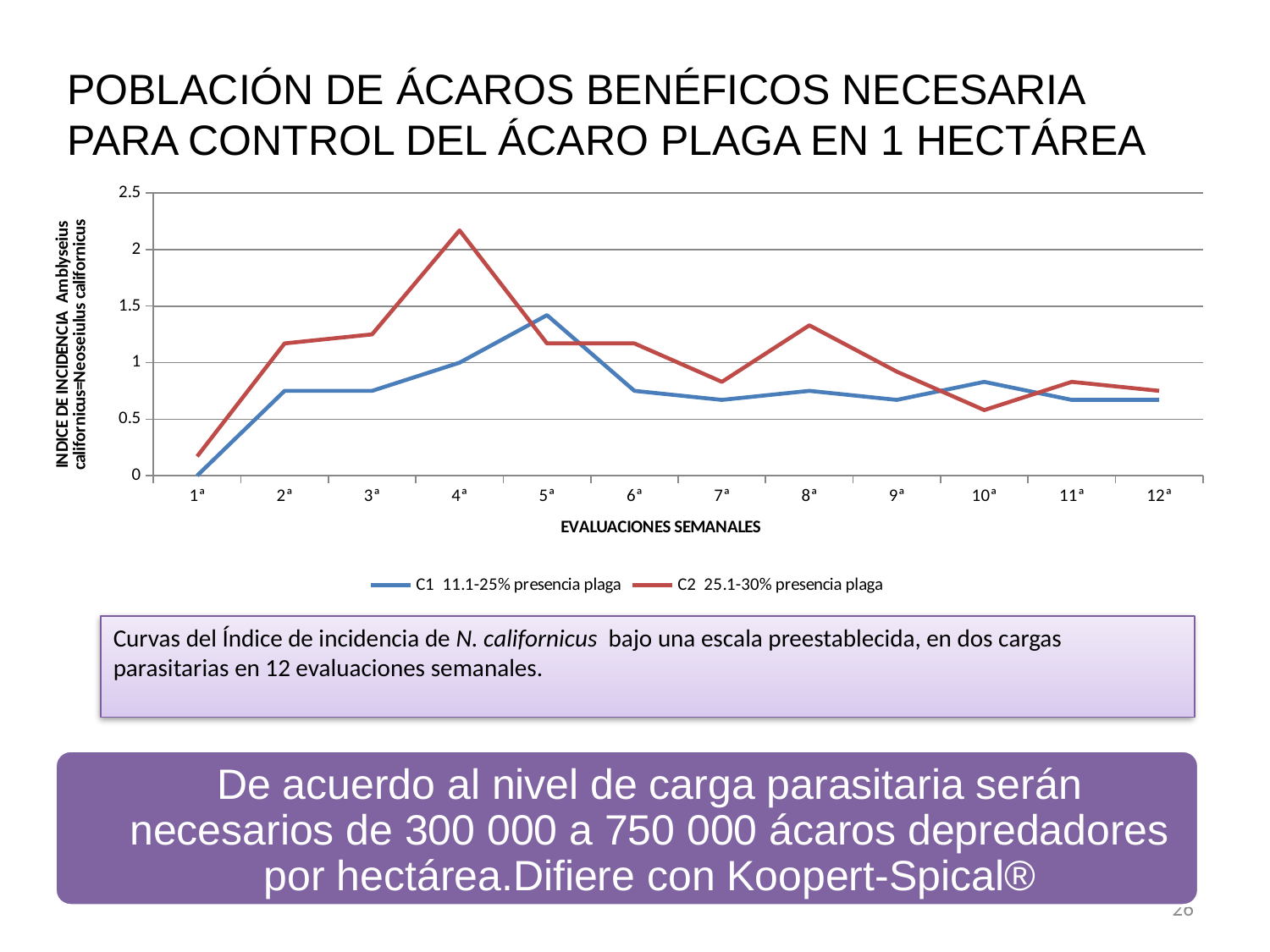
What is the value of the series C1 11.1-25% presencia plaga at evaluation 1ª? 0 At evaluation 4ª, which series has the larger value, C1 11.1-25% presencia plaga or C2 25.1-30% presencia plaga? C2 25.1-30% presencia plaga How many weekly evaluations are plotted along the x axis? 12 What kind of chart is shown on the slide? line chart How many series does the legend list? 2 Is the value for C2 25.1-30% presencia plaga at evaluation 4ª greater or less than 2? greater What is the title of the x axis of the chart? EVALUACIONES SEMANALES At which evaluation is the series C1 11.1-25% presencia plaga at its lowest value? 1ª At which evaluation does the series C1 11.1-25% presencia plaga reach its highest value? 5ª Is the value for C2 25.1-30% presencia plaga at evaluation 10ª greater or less than 1? less At which evaluation does the series C2 25.1-30% presencia plaga reach its highest value? 4ª Does the series C2 25.1-30% presencia plaga rise or fall from evaluation 4ª to evaluation 7ª? fall